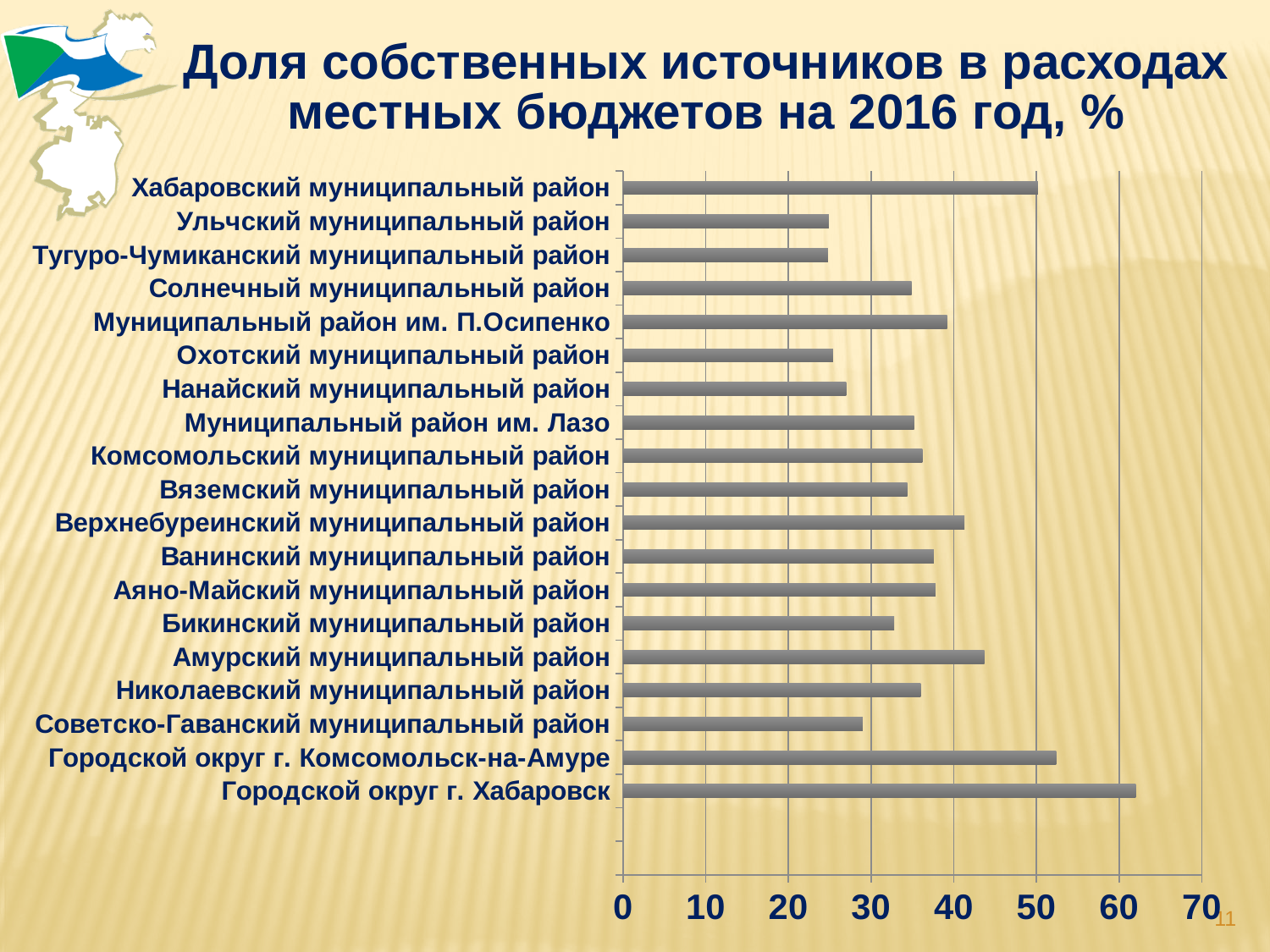
Is the value for Советско-Гаванский муниципальный район greater or less than 30? less Which has a larger value: Хабаровский муниципальный район or Ульчский муниципальный район? Хабаровский муниципальный район Is the value for Бикинский муниципальный район greater or less than 30? greater Is the value for Городской округ г. Комсомольск-на-Амуре greater or less than 50? greater What is the title of the chart on the slide? Доля собственных источников в расходах местных бюджетов на 2016 год, % What kind of chart is shown on the slide? bar chart Which has a larger value: Амурский муниципальный район or Бикинский муниципальный район? Амурский муниципальный район How many categories (municipalities) are plotted in the chart? 19 Which category has the highest value in the chart? Городской округ г. Хабаровск